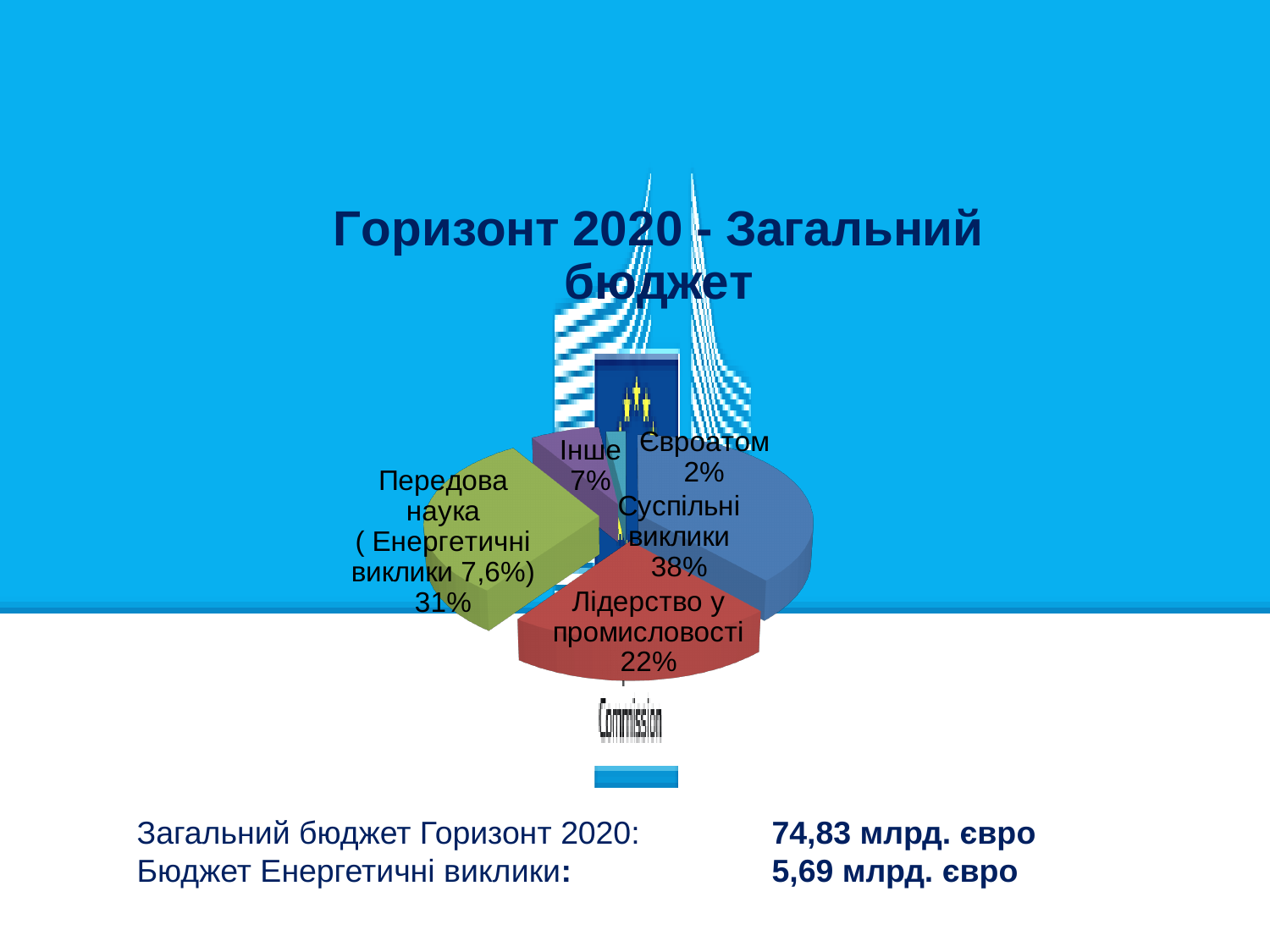
How many slices does the pie chart have? 5 What kind of chart is shown on the slide? pie chart What share of the pie does "Євроатом" have? 2% What share of the pie does "Інше" have? 7% Which slice of the pie is the smallest? Євроатом What share of the pie does "Суспільні виклики" have? 38% What is the title of the chart? Горизонт 2020 - Загальний бюджет Which is larger, the share for "Передова наука" or the share for "Лідерство у промисловості"? Передова наука What share of the pie does "Лідерство у промисловості" have? 22% Which slice of the pie is the largest? Суспільні виклики What is the difference in percentage points between "Суспільні виклики" and "Лідерство у промисловості"? 16 What share of the pie does "Передова наука" have? 31%